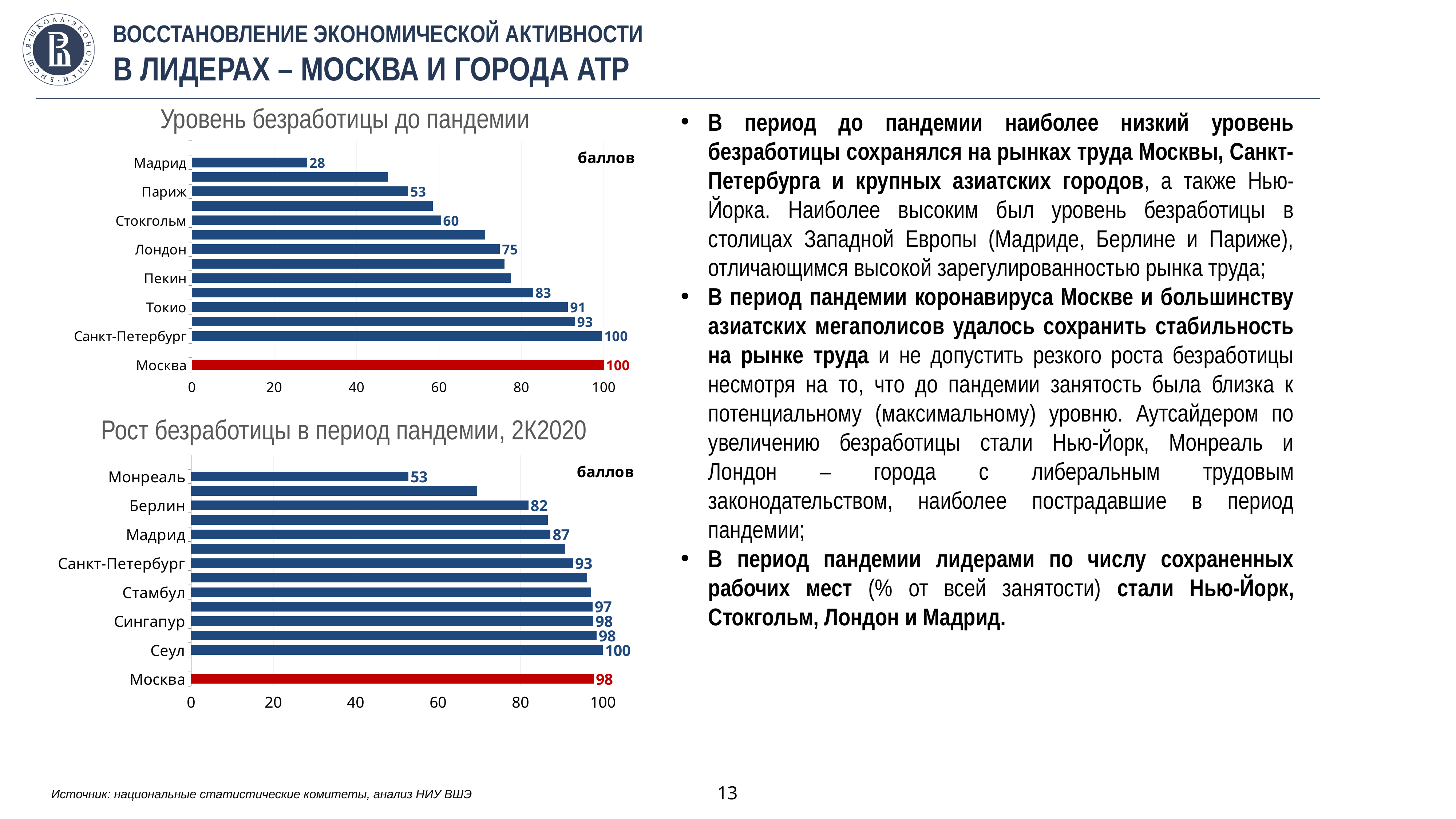
In the chart 'Рост безработицы в период пандемии, 2К2020', is the value for Стамбул greater or less than 80? greater What type of chart is 'Уровень безработицы до пандемии'? bar chart In the chart 'Уровень безработицы до пандемии', is the value for Пекин greater or less than 60? greater In the chart 'Уровень безработицы до пандемии', what is the value for Лондон? 75 In the chart 'Рост безработицы в период пандемии, 2К2020', what is the value for Монреаль? 53 In the chart 'Рост безработицы в период пандемии, 2К2020', which labeled city has the lowest value? Монреаль In the chart 'Уровень безработицы до пандемии', which is larger: the value for Стокгольм or for Токио? Токио In the chart 'Уровень безработицы до пандемии', which labeled city has the lowest value? Мадрид In the chart 'Рост безработицы в период пандемии, 2К2020', what is the value for Москва? 98 In the chart 'Рост безработицы в период пандемии, 2К2020', what is the difference between the values for Мадрид and Берлин? 5 In the chart 'Уровень безработицы до пандемии', what is the value for Мадрид? 28 In the chart 'Уровень безработицы до пандемии', what is the difference between the values for Токио and Париж? 38